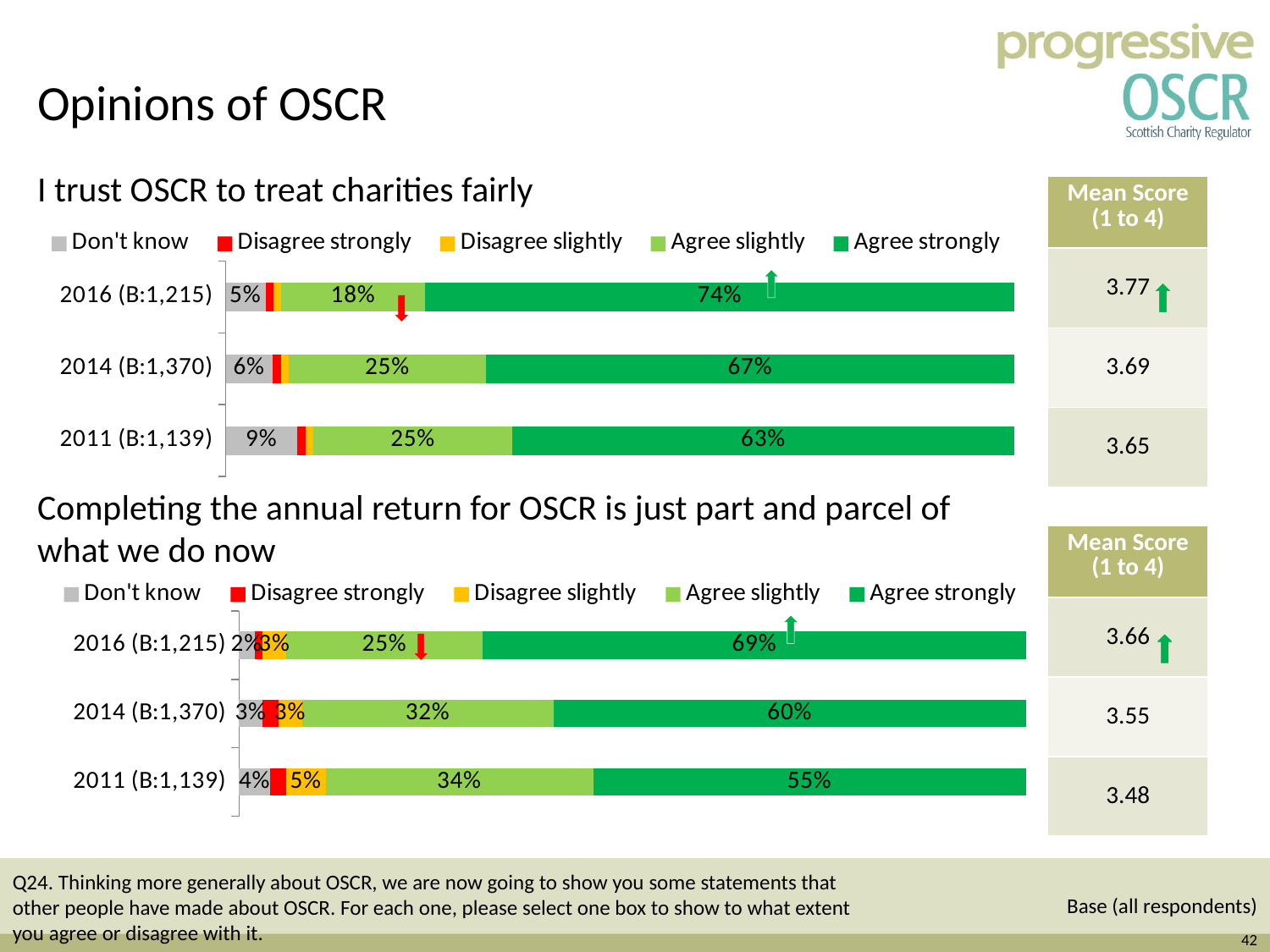
In the chart 'Completing the annual return for OSCR is just part and parcel of what we do now', is the 'Agree strongly' percentage larger for 2016 or 2014? 2016 In the chart 'Completing the annual return for OSCR is just part and parcel of what we do now', what percentage of respondents in 2011 disagreed slightly? 5% In the chart 'I trust OSCR to treat charities fairly', how many series does the legend list? 5 In the chart 'I trust OSCR to treat charities fairly', what percentage of respondents in 2011 answered 'Don't know'? 9% In the chart 'I trust OSCR to treat charities fairly', what percentage of respondents in 2016 agreed strongly? 74% What type of chart is used for 'I trust OSCR to treat charities fairly'? Stacked bar chart In the chart 'Completing the annual return for OSCR is just part and parcel of what we do now', how does the 'Agree slightly' percentage change from 2011 to 2016? It falls In the chart 'Completing the annual return for OSCR is just part and parcel of what we do now', what percentage of respondents in 2014 agreed slightly? 32% In the chart 'I trust OSCR to treat charities fairly', what is the difference between the 'Agree strongly' percentages for 2016 and 2011? 11% How many years (categories) are shown in the chart 'Completing the annual return for OSCR is just part and parcel of what we do now'? 3 In the chart 'Completing the annual return for OSCR is just part and parcel of what we do now', which year has the lowest 'Agree strongly' percentage? 2011 (B:1,139) In the chart 'I trust OSCR to treat charities fairly', which year has the highest 'Agree strongly' percentage? 2016 (B:1,215)